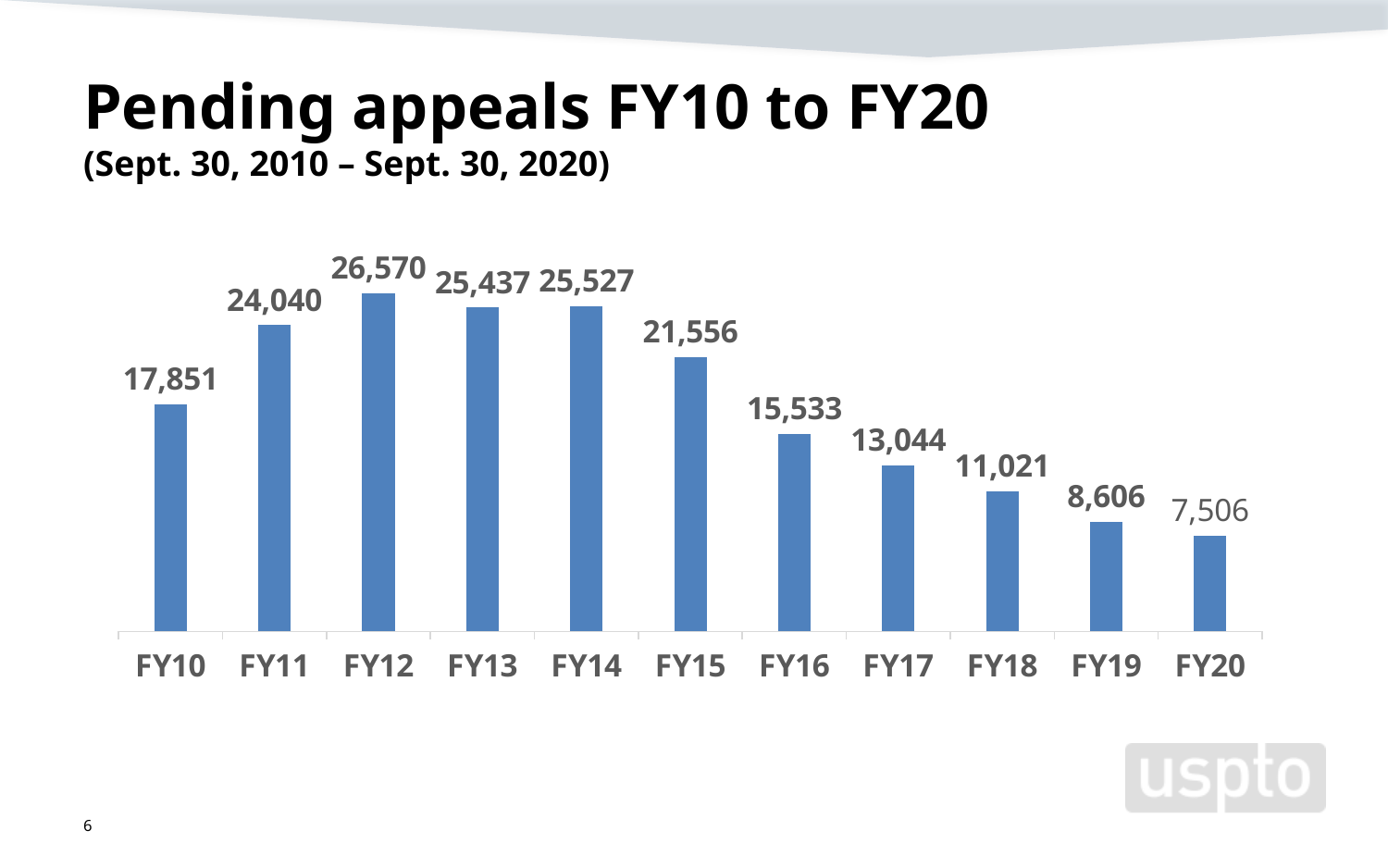
Which fiscal year has the highest number of pending appeals? FY12 How many fiscal years are shown on the chart? 11 Do pending appeals rise or fall from FY14 to FY20? Fall What is the number of pending appeals for FY20? 7,506 Which has more pending appeals, FY13 or FY14? FY14 What kind of chart is shown on the slide? Bar chart What is the difference in pending appeals between FY12 and FY20? 19,064 What is the number of pending appeals for FY16? 15,533 What is the difference in pending appeals between FY10 and FY11? 6,189 Which has more pending appeals, FY10 or FY15? FY15 What is the number of pending appeals for FY12? 26,570 Which fiscal year has the lowest number of pending appeals? FY20